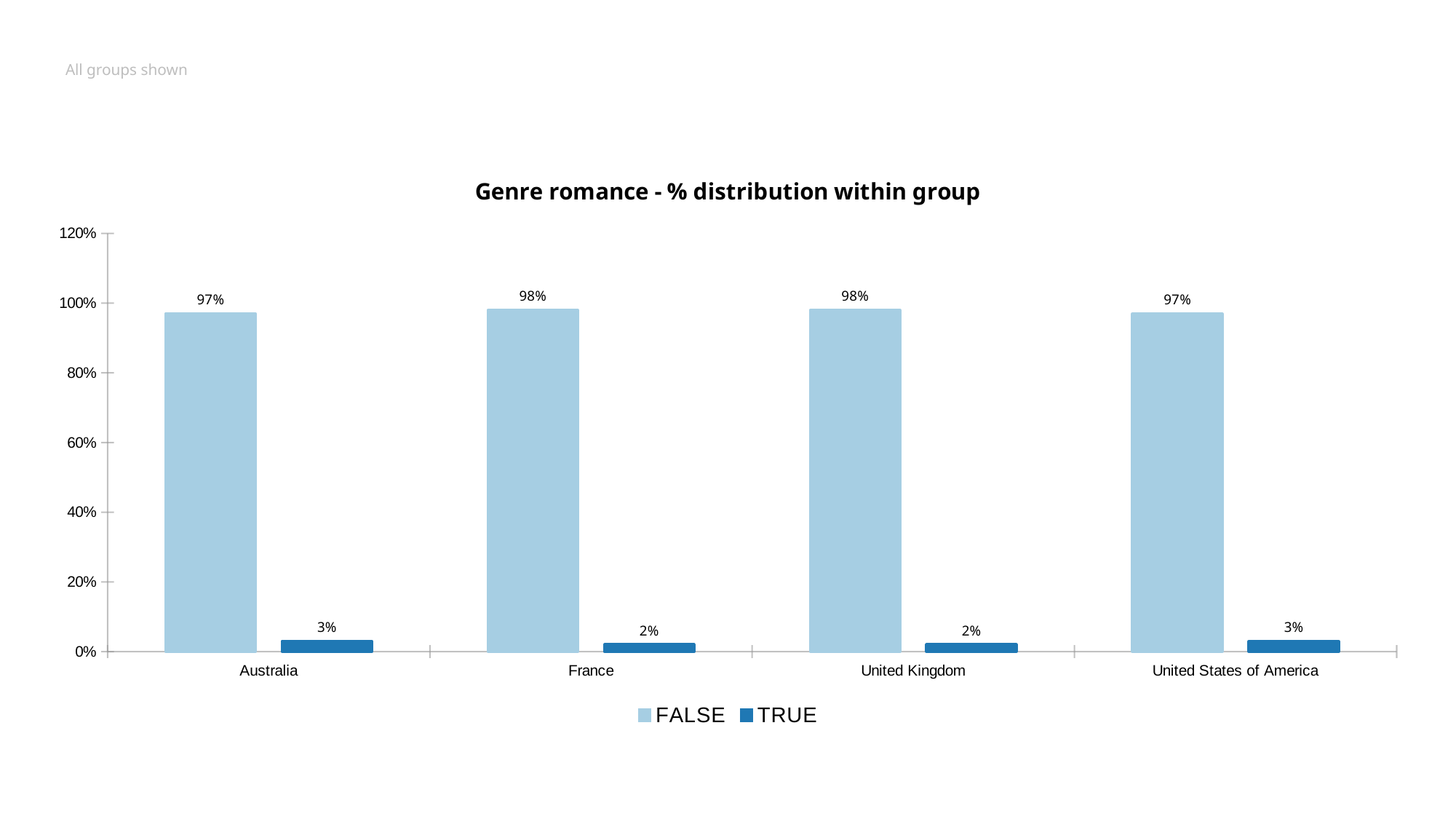
What is the difference between the FALSE and TRUE values for Australia? 94% Is the FALSE value for France greater or less than 80%? greater How many countries are shown on the x axis? 4 What is the FALSE value for Australia? 97% What kind of chart is shown? bar chart Which is larger for United Kingdom, the FALSE value or the TRUE value? FALSE What is the TRUE value for France? 2% What is the TRUE value for United States of America? 3% What is the difference between the FALSE and TRUE values for France? 96% What is the title of the chart? Genre romance - % distribution within group What is the FALSE value for United Kingdom? 98% How many series does the legend list? 2